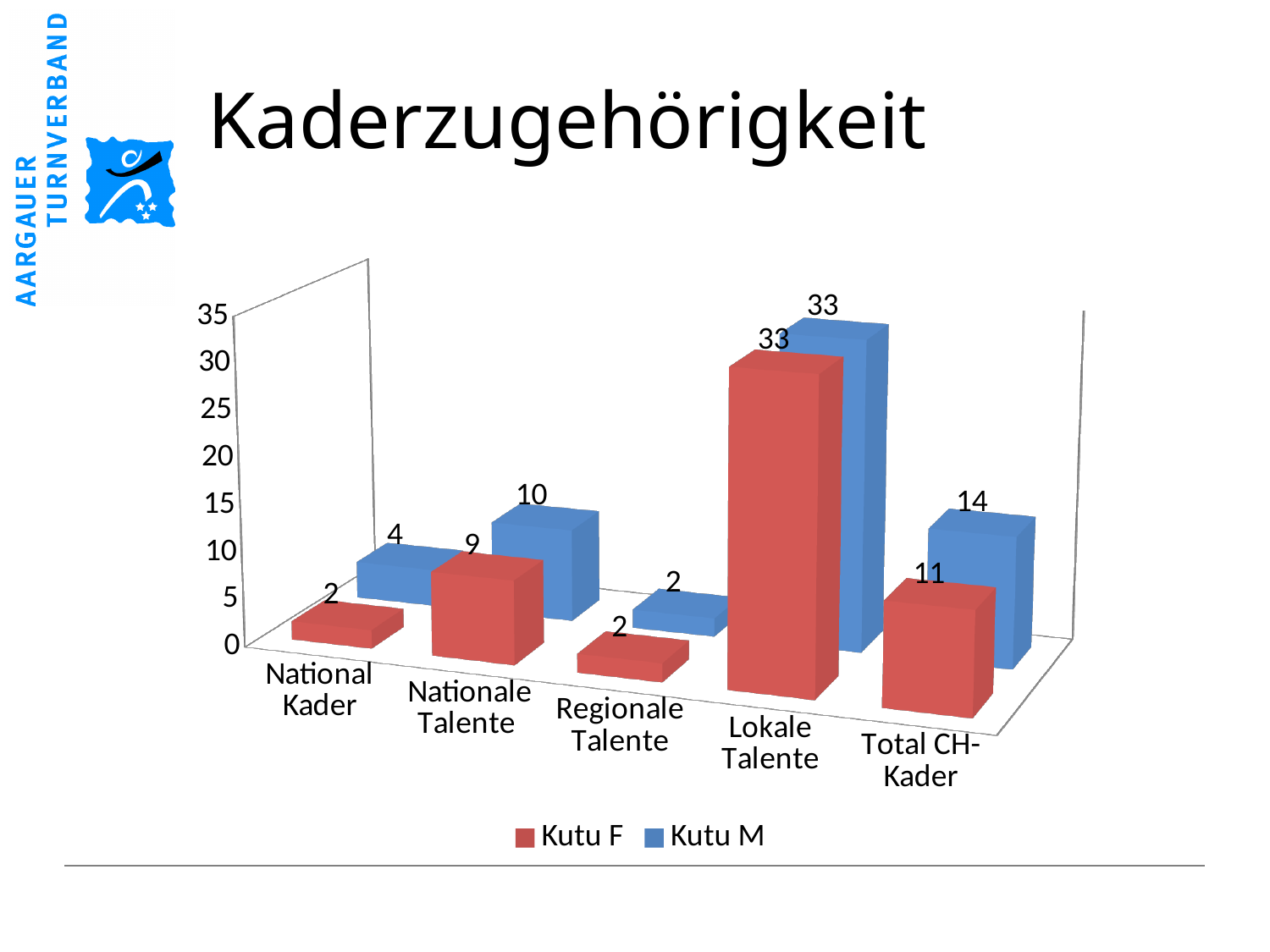
What is the title of the slide? Kaderzugehörigkeit How many categories are shown on the x axis? 5 Which category has the highest value for Kutu F? Lokale Talente What kind of chart is shown on the slide? Bar chart What is the value for Kutu M in the National Kader category? 4 How many series does the legend list? 2 What is the difference between Kutu M and Kutu F in the Nationale Talente category? 1 Which category has the lowest value for Kutu M? Regionale Talente What is the value for Kutu F in the Nationale Talente category? 9 What is the difference between Kutu M and Kutu F in the Total CH-Kader category? 3 Which is larger in the National Kader category, Kutu F or Kutu M? Kutu M What is the value for Kutu M in the Total CH-Kader category? 14